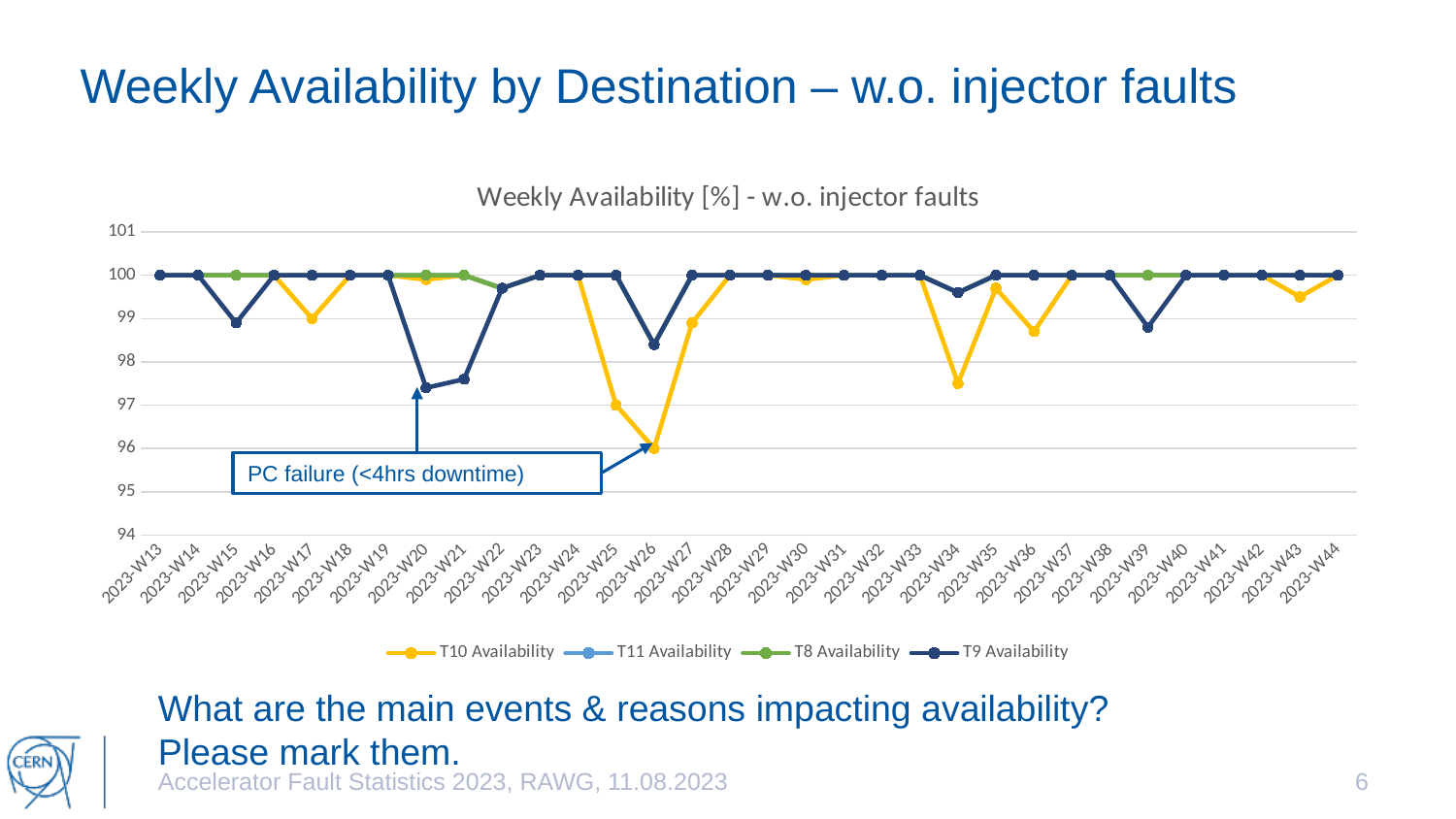
In 2023-W26, which is larger: T10 Availability or T9 Availability? T9 Availability Is the T9 Availability value for 2023-W20 greater or less than 98? less Does T10 Availability rise or fall from 2023-W24 to 2023-W26? fall In which week does T9 Availability reach its lowest value? 2023-W20 Is the T9 Availability value for 2023-W26 greater or less than 98? greater How many series does the legend list? 4 In which week does T10 Availability reach its lowest value? 2023-W26 What does the annotation box on the chart say? PC failure (<4hrs downtime) What kind of chart is shown on the slide? line chart Is the T10 Availability value for 2023-W36 greater or less than 99? less How many weeks are plotted along the x axis? 32